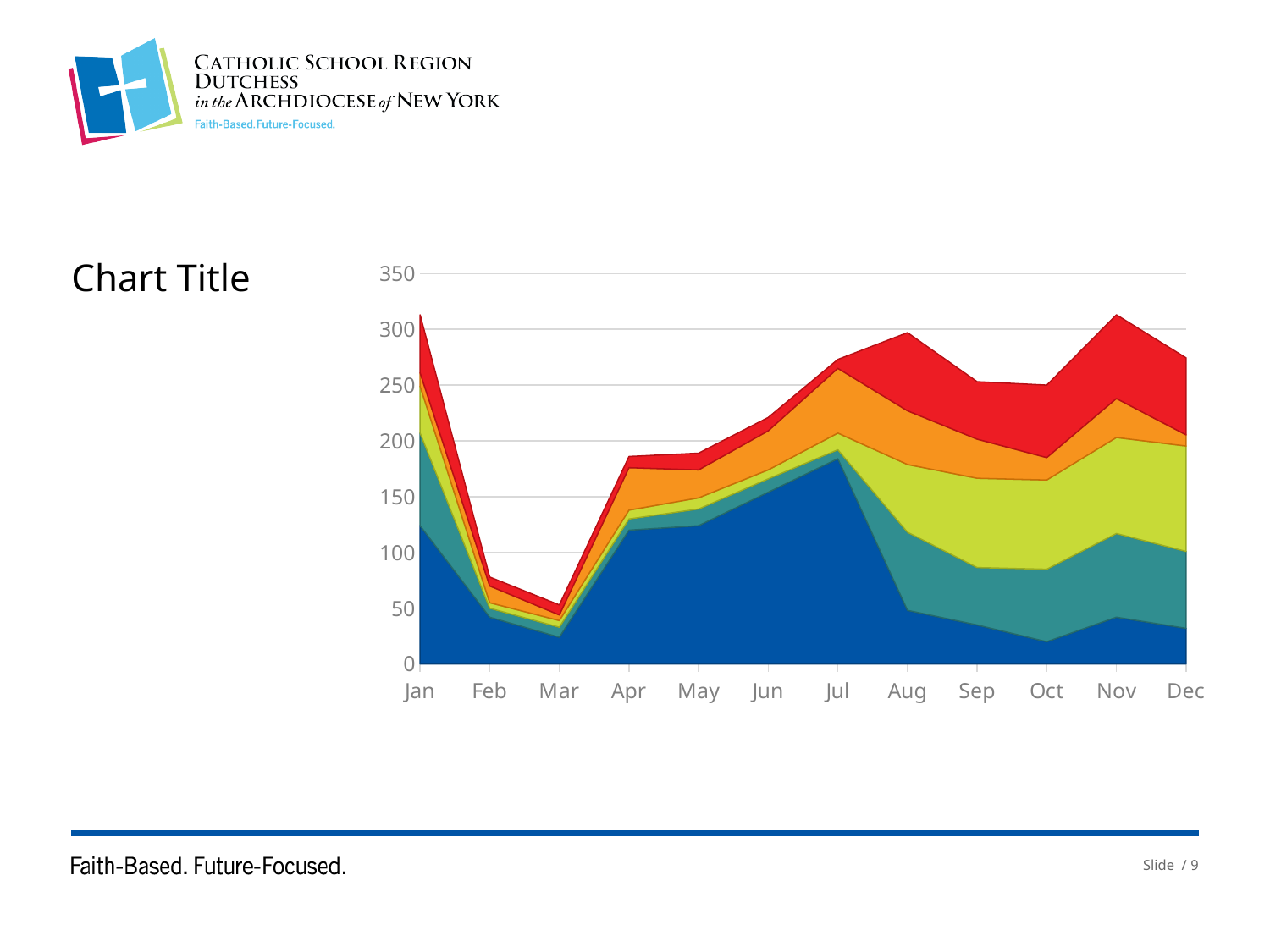
Is the value of the bottom (blue) series in Jul greater or less than 150? greater Is the value of the bottom (blue) series in Oct greater or less than 50? less Is the stacked total for Aug greater or less than 250? greater What is the title of the chart? Chart Title How many coloured series are stacked in the chart? 5 What kind of chart is shown on the slide? Stacked area chart How many months are shown along the x axis of the chart? 12 Does the stacked total rise or fall from Mar to Jul? rise Which month has the larger stacked total, Feb or Jul? Jul Which month has the lowest stacked total in the chart? Mar